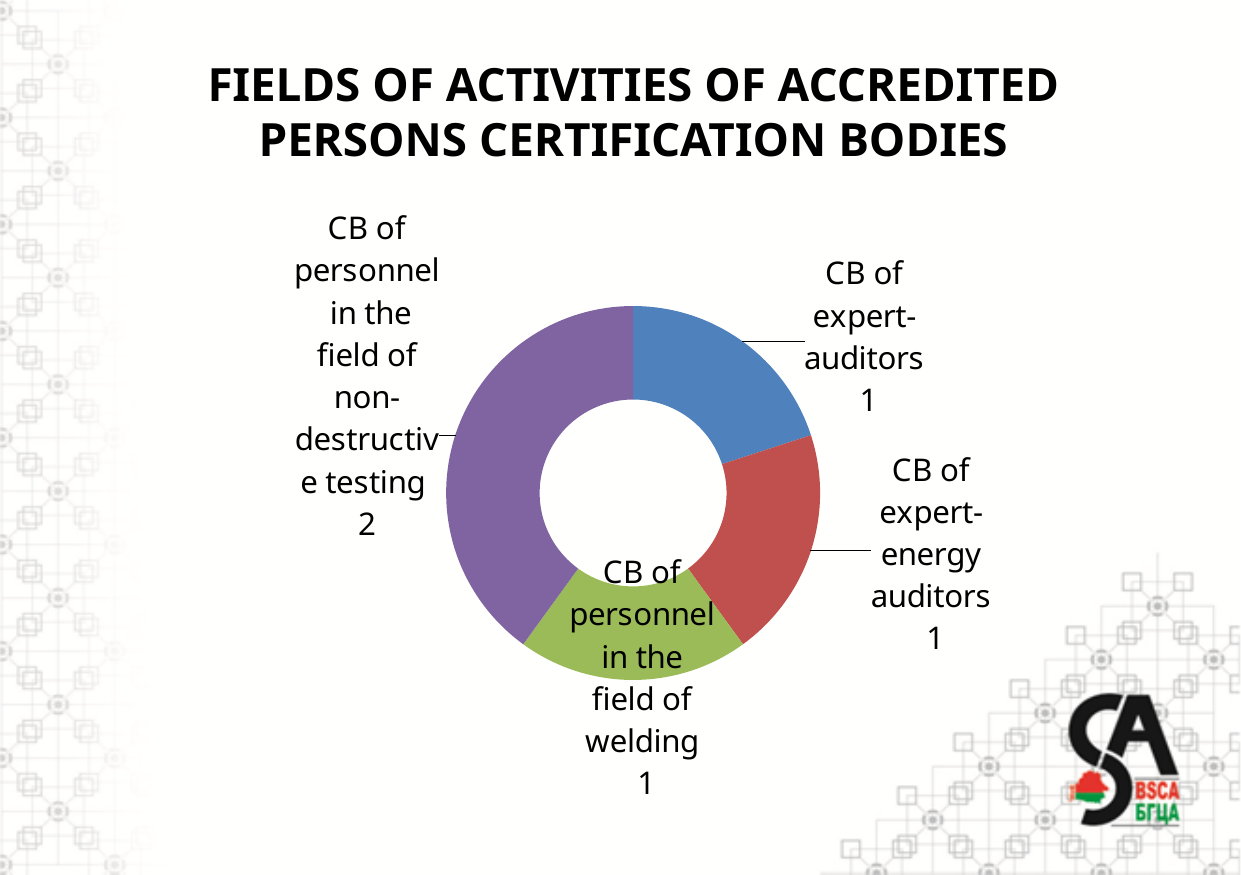
What is the value for CB of expert-energy auditors? 1 What is the difference between the value for CB of personnel in the field of non-destructive testing and the value for CB of personnel in the field of welding? 1 What is the title of the slide? FIELDS OF ACTIVITIES OF ACCREDITED PERSONS CERTIFICATION BODIES Which category has the highest value? CB of personnel in the field of non-destructive testing What share of the total does CB of personnel in the field of non-destructive testing represent? 40% What is the value for CB of personnel in the field of welding? 1 What kind of chart is shown on the slide? Doughnut chart How many categories are shown in the chart? 4 What is the value for CB of personnel in the field of non-destructive testing? 2 What is the total of all values shown in the chart? 5 Which is larger: the value for CB of personnel in the field of non-destructive testing or the value for CB of expert-auditors? CB of personnel in the field of non-destructive testing What is the value for CB of expert-auditors? 1